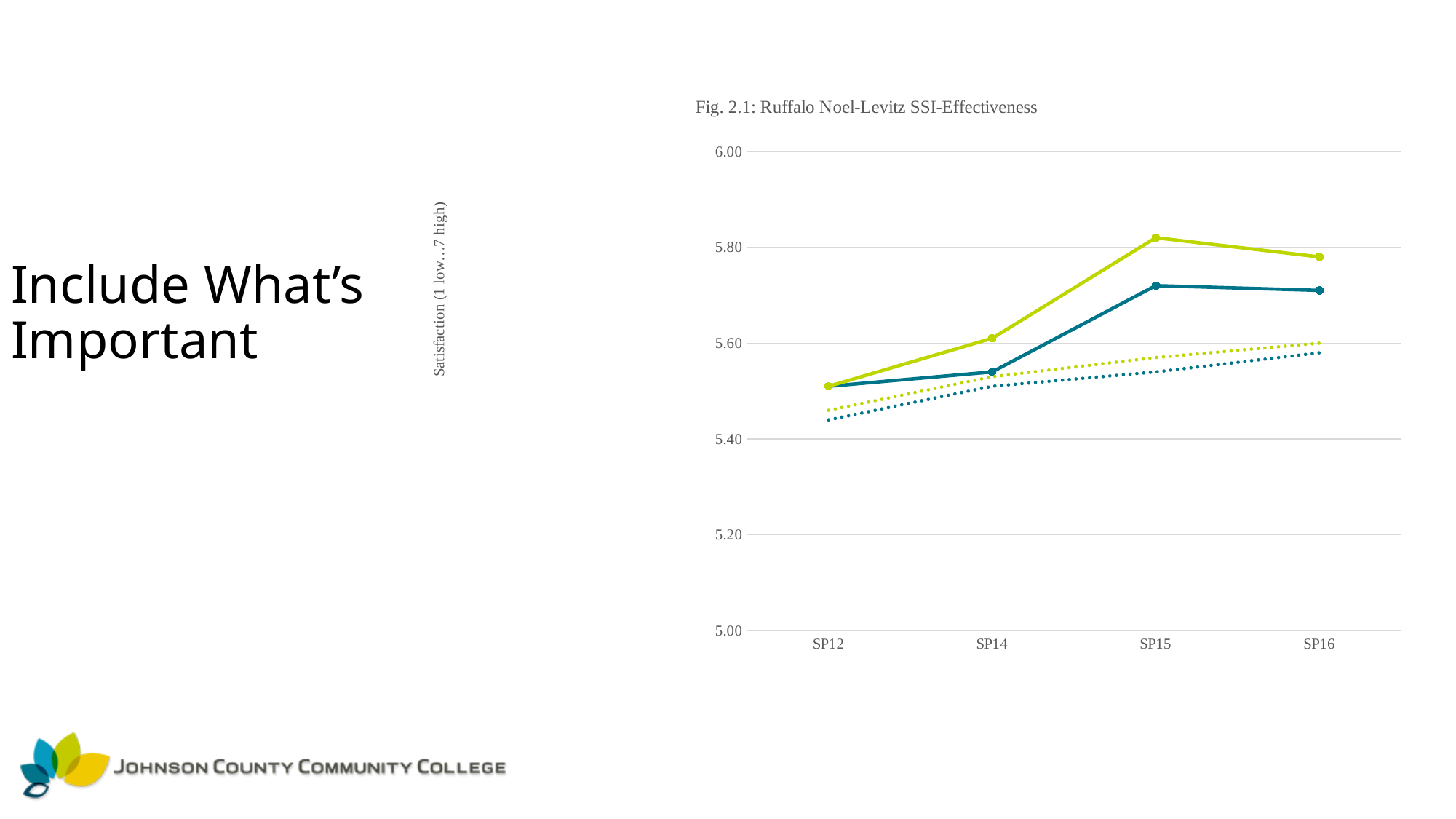
Is the value of the solid green line at SP15 greater or less than 5.80? greater Is the value of the solid teal line at SP14 greater or less than 5.60? less At which category does the solid green line reach its highest value? SP15 What is the title of the chart? Fig. 2.1: Ruffalo Noel-Levitz SSI-Effectiveness Is the value of the solid teal line at SP15 greater or less than 5.80? less What kind of chart is shown on the slide? line chart Does the solid green line rise or fall from SP12 to SP15? rise What is the label on the vertical axis of the chart? Satisfaction (1 low…7 high) At which category does the solid teal line have its lowest value? SP12 At SP15, which solid line has the higher value, the green line or the teal line? the green line How many categories are shown on the x axis of the chart? 4